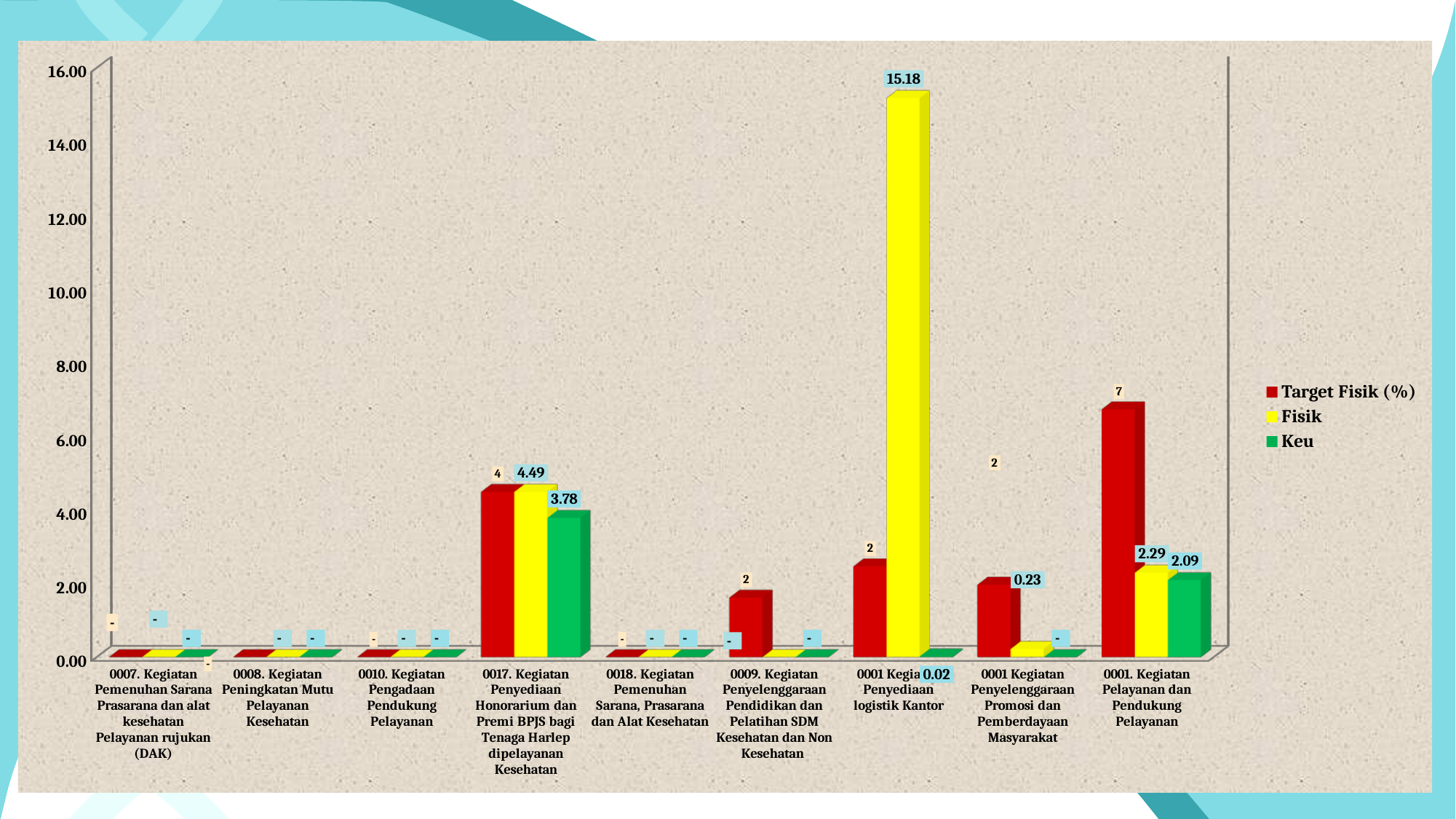
How many categories are shown on the x axis? 9 What is the Fisik value for 0001 Kegiatan Penyediaan logistik Kantor? 15.18 Is the Fisik value for 0001 Kegiatan Penyediaan logistik Kantor greater or less than 14.00? greater How many series does the legend list? 3 What is the Keu value for 0001 Kegiatan Penyediaan logistik Kantor? 0.02 What is the Fisik value for 0001 Kegiatan Penyelenggaraan Promosi dan Pemberdayaan Masyarakat? 0.23 What kind of chart is shown on the slide? bar chart What is the difference between the Fisik and Keu values for 0017. Kegiatan Penyediaan Honorarium dan Premi BPJS bagi Tenaga Harlep dipelayanan Kesehatan? 0.71 For 0001. Kegiatan Pelayanan dan Pendukung Pelayanan, which is larger: the Fisik value or the Keu value? Fisik What is the Keu value for 0017. Kegiatan Penyediaan Honorarium dan Premi BPJS bagi Tenaga Harlep dipelayanan Kesehatan? 3.78 Which category has the highest Target Fisik (%) value? 0001. Kegiatan Pelayanan dan Pendukung Pelayanan Which category has the highest Fisik value? 0001 Kegiatan Penyediaan logistik Kantor